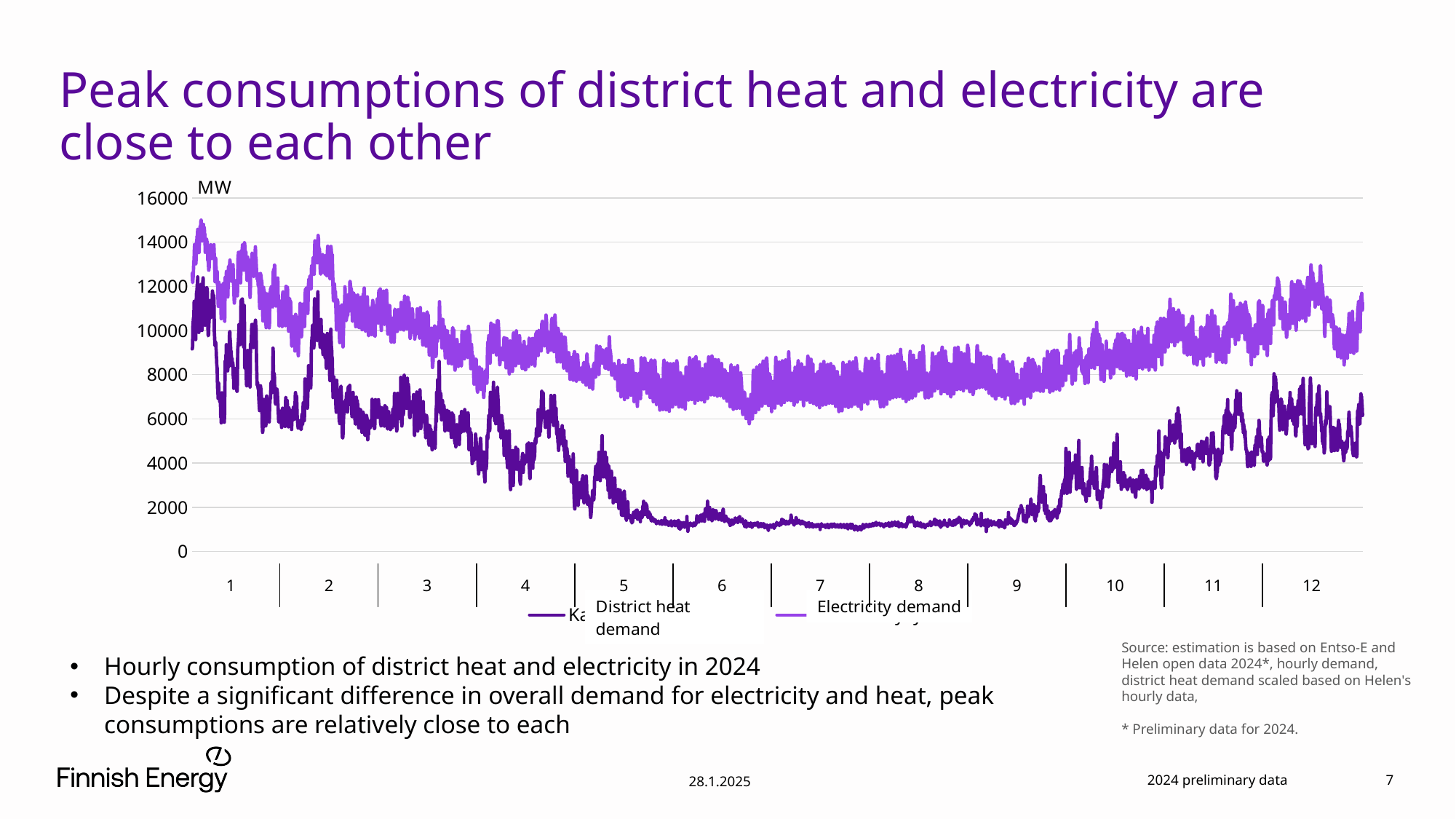
How many series does the chart's legend list? 2 In month 6, which series is higher: District heat demand or Electricity demand? Electricity demand Is the highest electricity demand in month 1 greater or less than 14000 MW? greater What kind of chart is shown on the slide? line chart How many months are labelled along the x axis of the chart? 12 Is the electricity demand in month 7 greater or less than 6000 MW? greater Does the electricity demand rise or fall from month 7 to month 12? rise Is the district heat demand in month 7 greater or less than 2000 MW? less What unit is shown at the top of the y axis? MW Does the district heat demand rise or fall from month 1 to month 7? fall What are the two series named in the chart's legend? District heat demand and Electricity demand